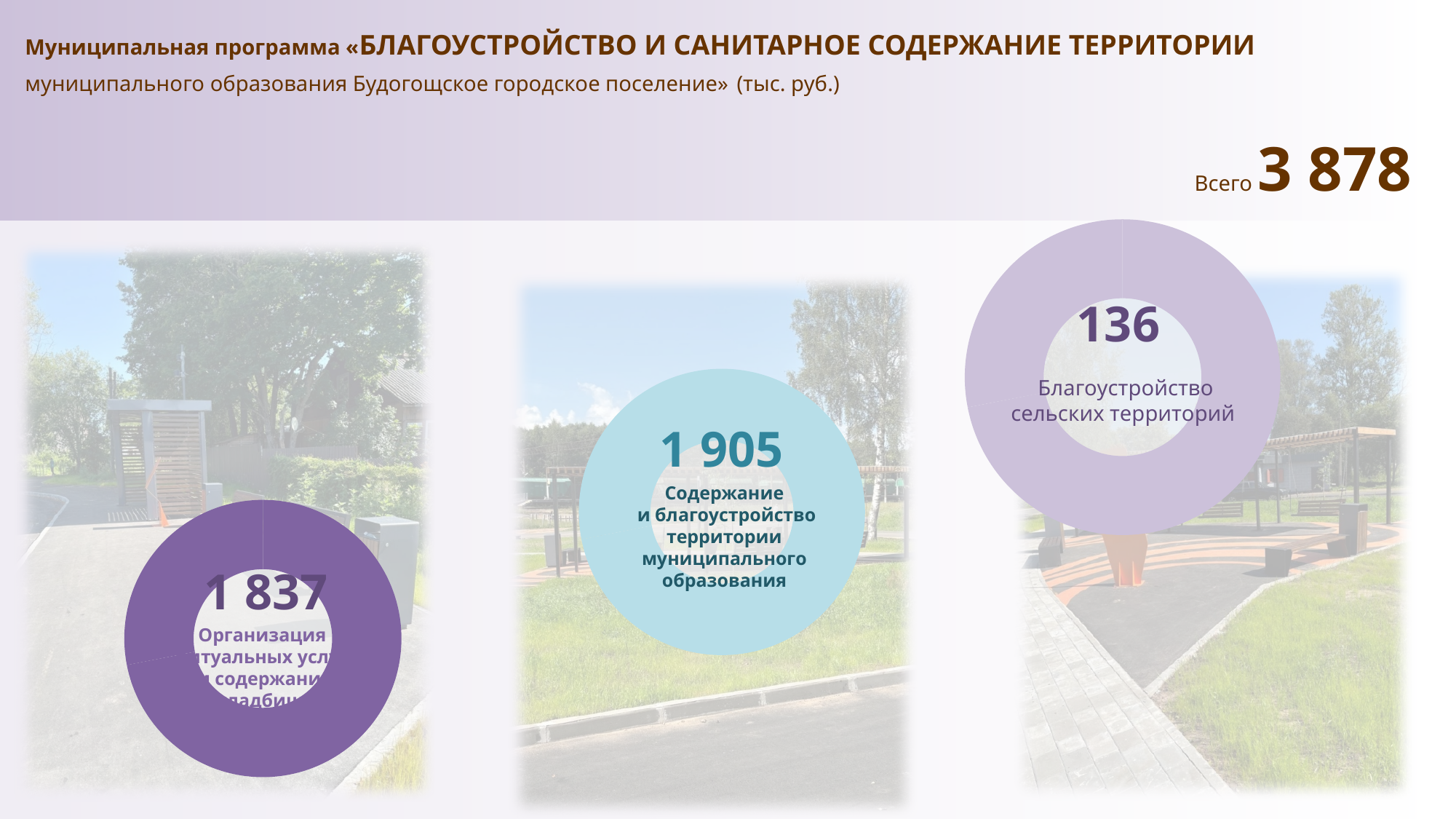
What is the value shown for «Благоустройство сельских территорий»? 136 Which category has the highest value on the slide? Содержание и благоустройство территории муниципального образования What colour is the circle for «Содержание и благоустройство территории муниципального образования»? light blue What is the difference between the value in the middle circle (1 905) and the value in the left circle (1 837)? 68 What total («Всего») is shown on the slide? 3 878 How many categories (circles) are shown on the slide? 3 Which is larger: the value in the left circle or the value in the middle circle? the middle circle (1 905) Which category has the lowest value on the slide? Благоустройство сельских территорий What is the difference between the value for «Содержание и благоустройство территории муниципального образования» and the value for «Благоустройство сельских территорий»? 1 769 What value is printed in the left (dark purple) circle? 1 837 In what units are the values on the slide given? тыс. руб. What is the value shown for «Содержание и благоустройство территории муниципального образования»? 1 905